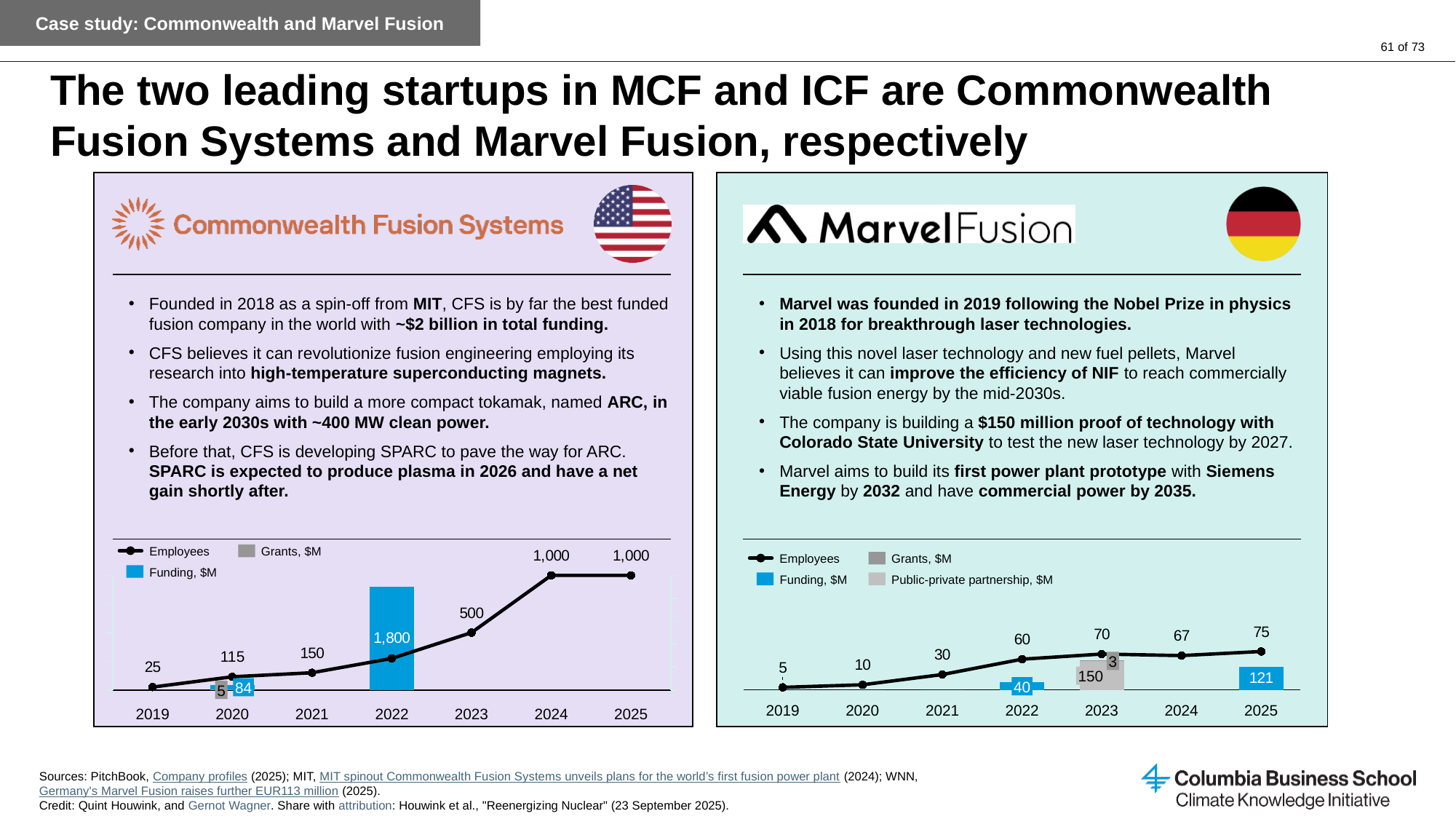
In the Marvel Fusion chart, how many series does the legend list? 4 In the Commonwealth Fusion Systems chart, what is the difference in employees between 2024 and 2023? 500 In the Marvel Fusion chart, which year has the lowest number of employees? 2019 In the Commonwealth Fusion Systems chart, how many employees are shown for 2023? 500 In the Commonwealth Fusion Systems chart, how many series does the legend list? 3 In the Marvel Fusion chart, which is larger, the employees in 2023 or in 2024? 2023 In the Commonwealth Fusion Systems chart, what is the Funding, $M value for 2022? 1,800 In the Commonwealth Fusion Systems chart, do employees rise or fall from 2019 to 2024? rise In the Marvel Fusion chart, what is the Public-private partnership, $M value for 2023? 150 In the Marvel Fusion chart, how many employees are shown for 2025? 75 In the Marvel Fusion chart, what is the Funding, $M value for 2022? 40 In the Commonwealth Fusion Systems chart, what is the Grants, $M value for 2020? 5